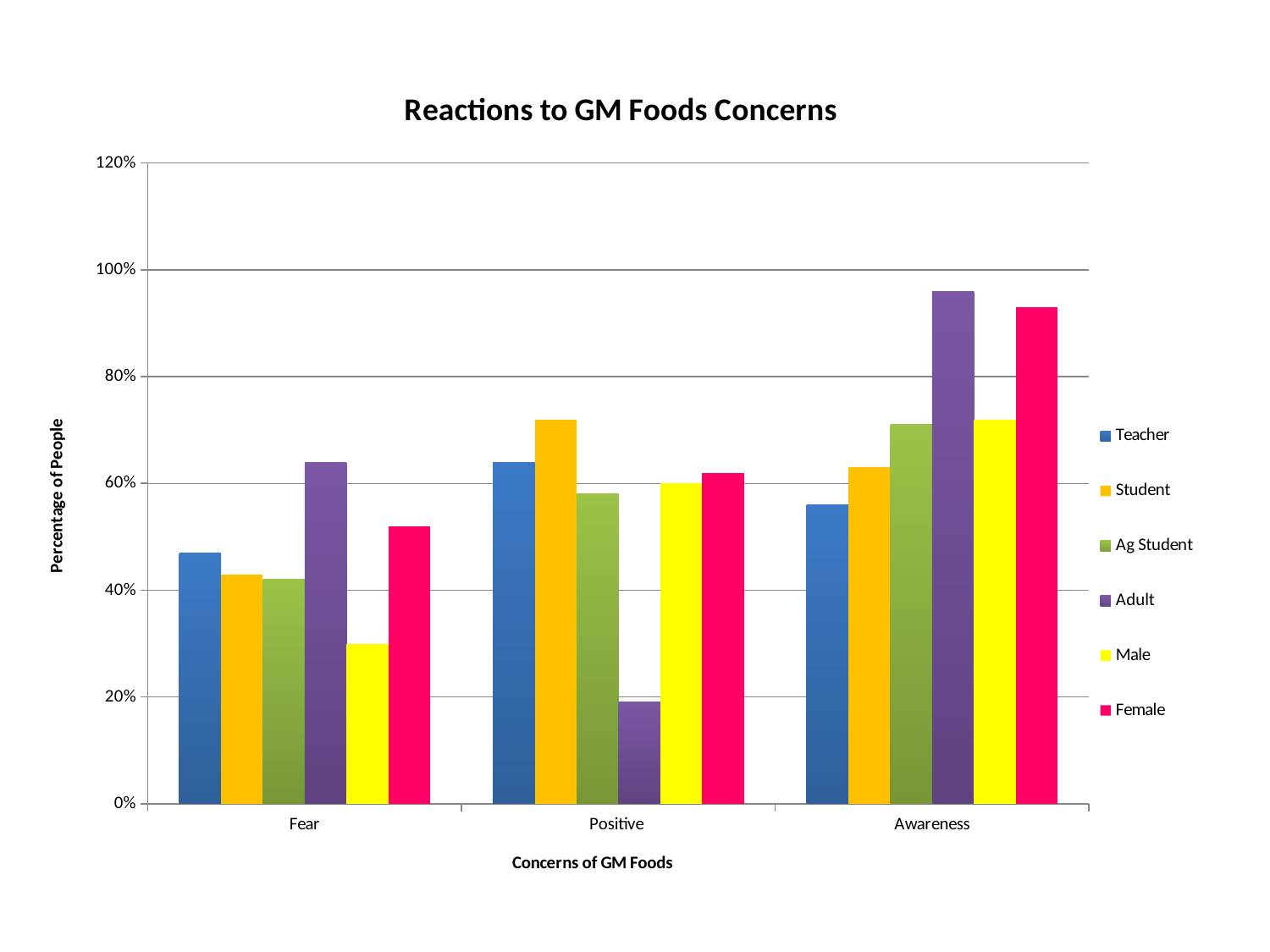
Which series has the lowest value in the Fear category? Male Is the value for Adult in the Awareness category greater or less than 80%? greater Which series has the highest value in the Fear category? Adult Which series has the lowest value in the Positive category? Adult Is the value for Student in the Positive category greater or less than 60%? greater What kind of chart is shown on the slide? bar chart Is the value for Male in the Fear category greater or less than 40%? less How many categories are shown on the x axis? 3 What is the title of the chart? Reactions to GM Foods Concerns Which is larger for the Male series: the value for Fear or the value for Awareness? Awareness How many series does the legend list? 6